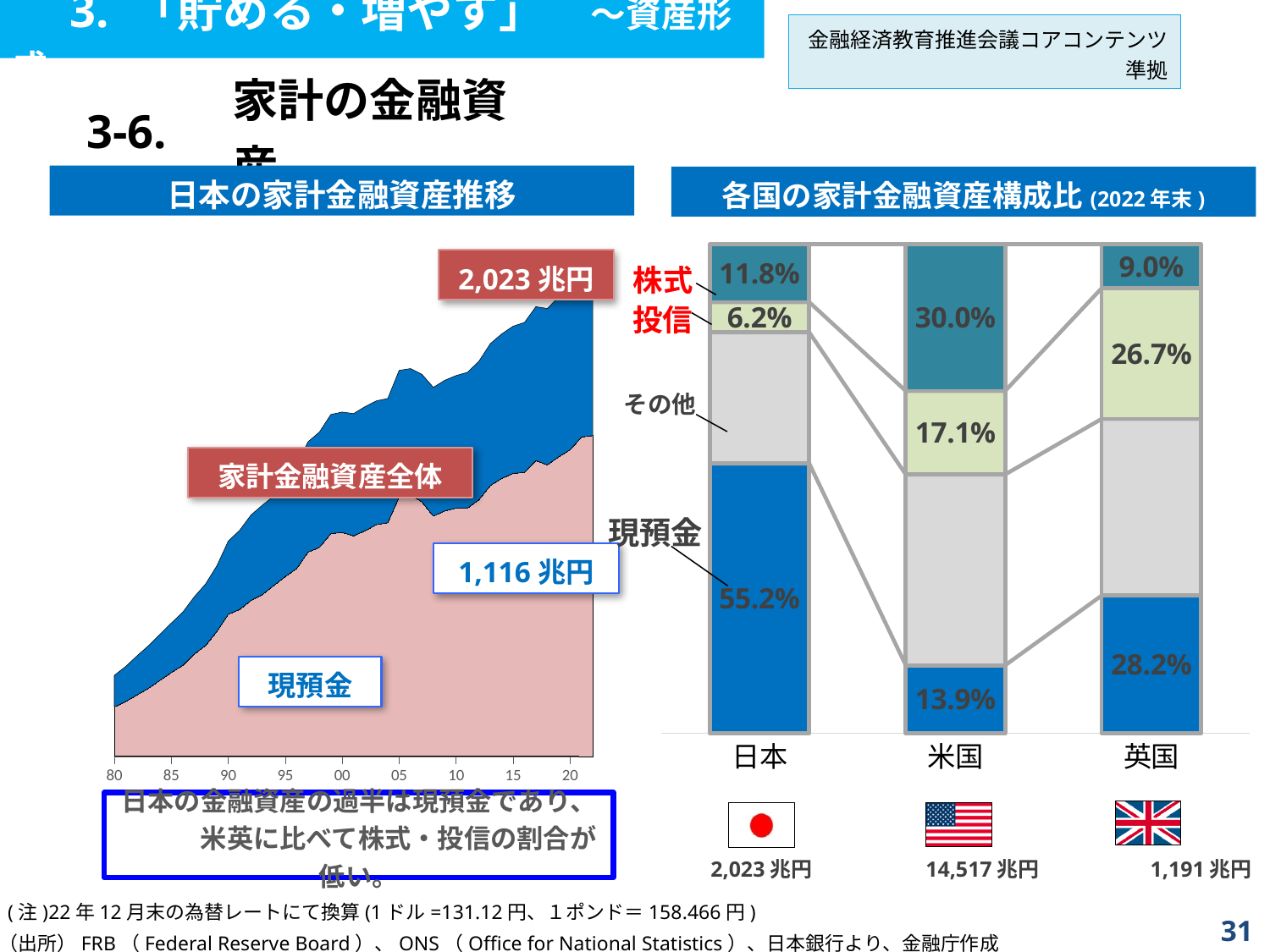
In the right chart (各国の家計金融資産構成比), what total household financial asset amount is shown under 米国? 14,517 兆円 In the right chart (各国の家計金融資産構成比), which country has the lowest 株式 share? 英国 In the right chart (各国の家計金融資産構成比), what is the difference between the 現預金 share of 日本 and that of 米国? 41.3% In the right chart (各国の家計金融資産構成比), what is the 投信 share for 英国? 26.7% In the right chart (各国の家計金融資産構成比), which country has the highest 現預金 share? 日本 In the right chart (各国の家計金融資産構成比), how many countries are compared? 3 In the left chart (日本の家計金融資産推移), what is the latest value labelled for 家計金融資産全体? 2,023 兆円 In the right chart (各国の家計金融資産構成比), what is the 現預金 share for 日本? 55.2% In the left chart (日本の家計金融資産推移), do the values for 家計金融資産全体 generally rise or fall from 80 to 20? rise In the left chart (日本の家計金融資産推移), what is the latest value labelled for 現預金? 1,116 兆円 In the right chart (各国の家計金融資産構成比), what is the 株式 share for 米国? 30.0% In the right chart (各国の家計金融資産構成比), is the 投信 share larger for 日本 or for 米国? 米国